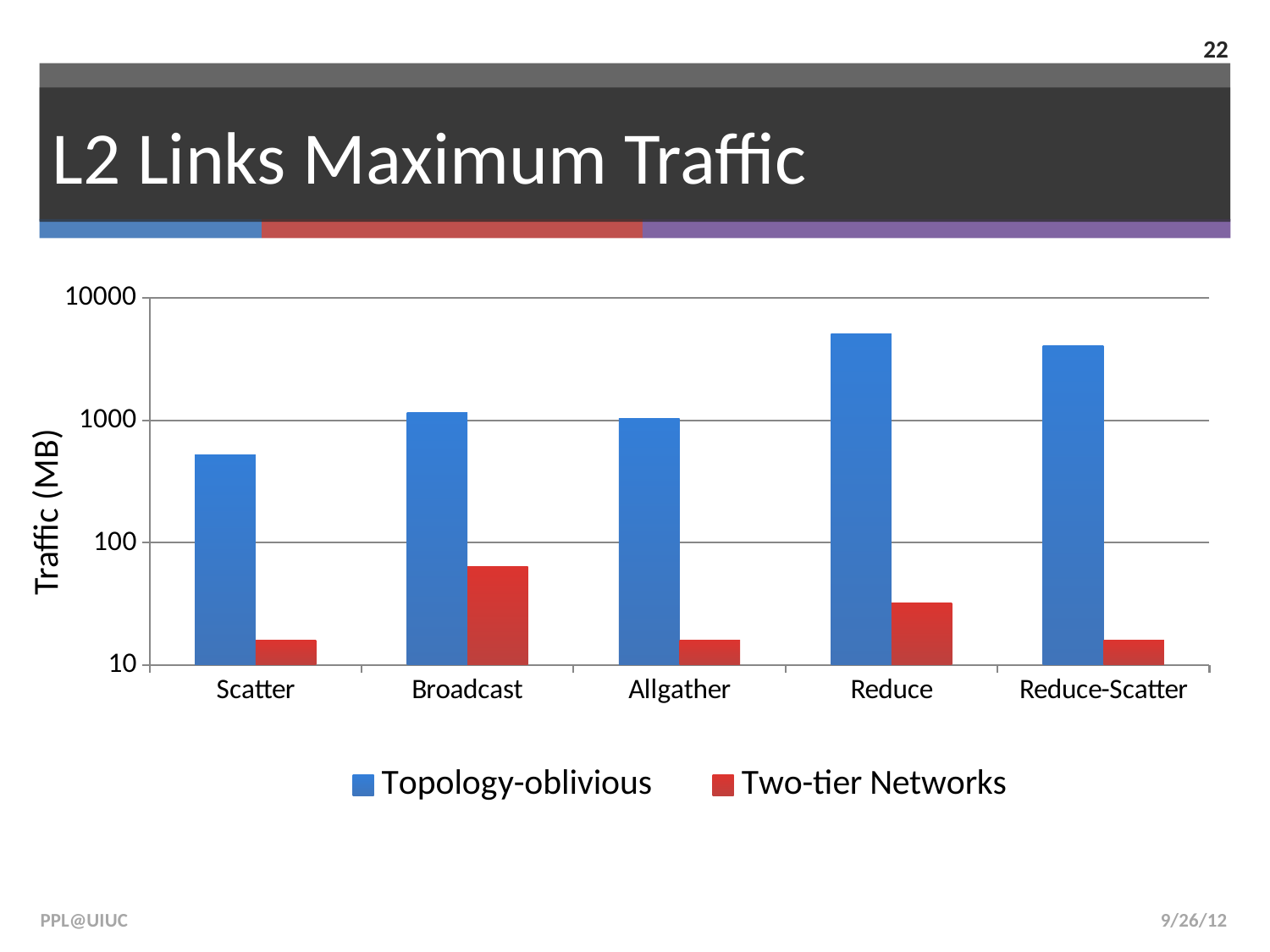
Which is larger for Reduce: the Topology-oblivious value or the Two-tier Networks value? Topology-oblivious How many categories are shown on the x axis? 5 What kind of chart is shown on the slide? bar chart Is the Two-tier Networks value for Broadcast greater or less than 100? less Which category has the lowest Topology-oblivious traffic? Scatter How many series does the legend list? 2 Is the Topology-oblivious value for Reduce greater or less than 1000? greater Is the Topology-oblivious value for Scatter greater or less than 1000? less What is the label of the y axis? Traffic (MB) Which category has the highest Two-tier Networks traffic? Broadcast Which category has the highest Topology-oblivious traffic? Reduce Which is larger for Two-tier Networks: Broadcast or Reduce? Broadcast